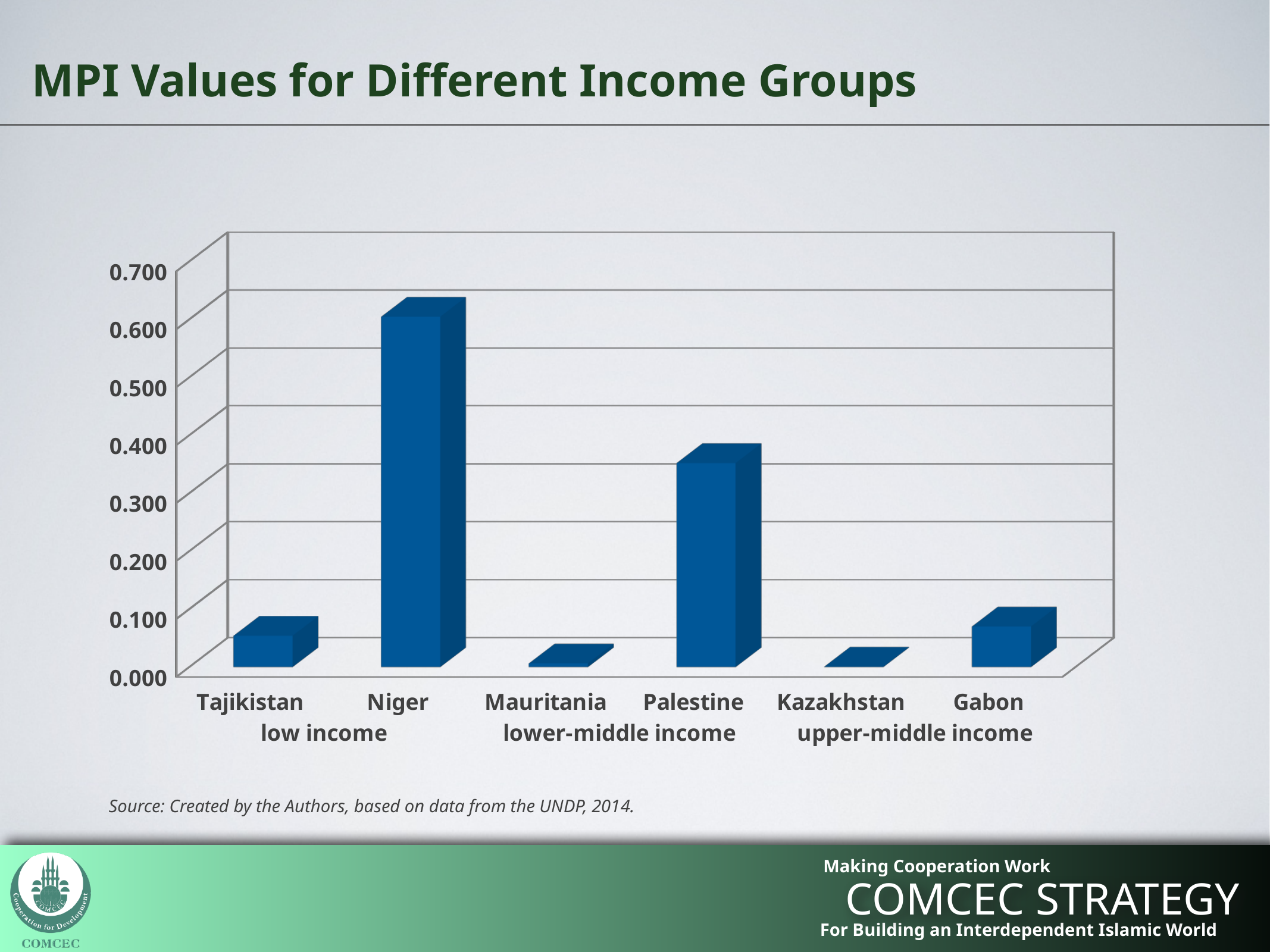
Is the MPI value for Tajikistan greater or less than 0.100? less Is the MPI value for Gabon greater or less than 0.100? less Which has a larger MPI value, Niger or Palestine? Niger Which has a larger MPI value, Palestine or Gabon? Palestine Which country has the highest MPI value? Niger How many countries are shown on the x axis? 6 What is the title of the chart? MPI Values for Different Income Groups What kind of chart is shown on the slide? bar chart How many income groups are labelled beneath the x axis? 3 Is the MPI value for Palestine greater or less than 0.400? less